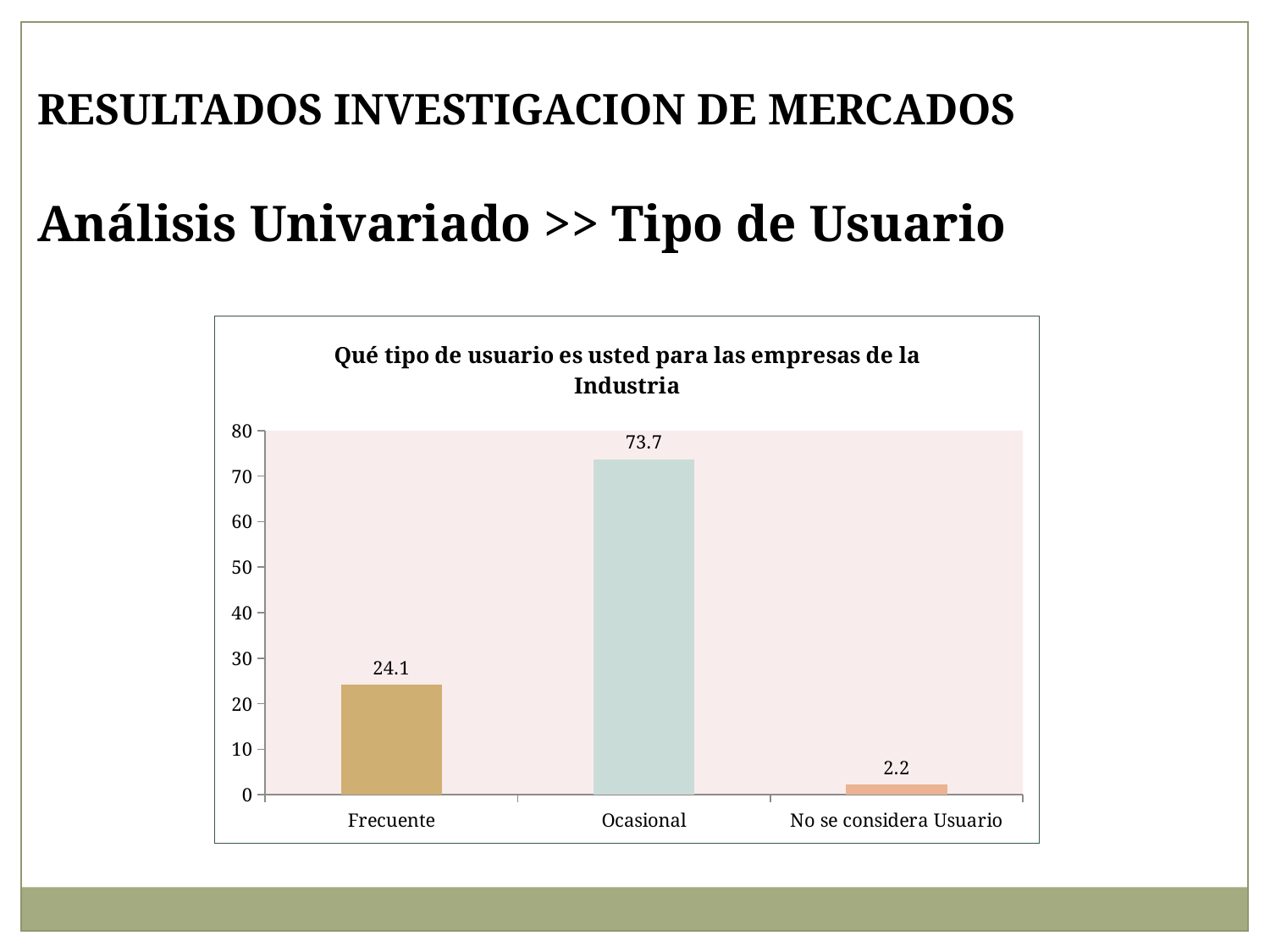
Which category has the highest value? Ocasional What is the value for Ocasional? 73.7 What is the difference between the values for Frecuente and No se considera Usuario? 21.9 What is the difference between the values for Ocasional and Frecuente? 49.6 What is the value for Frecuente? 24.1 How many categories are shown on the x axis? 3 Which is larger, the value for Frecuente or the value for Ocasional? Ocasional Which category has the lowest value? No se considera Usuario What is the title of the chart? Qué tipo de usuario es usted para las empresas de la Industria Is the value for Ocasional greater or less than 70? greater What is the value for No se considera Usuario? 2.2 What kind of chart is shown on the slide? bar chart